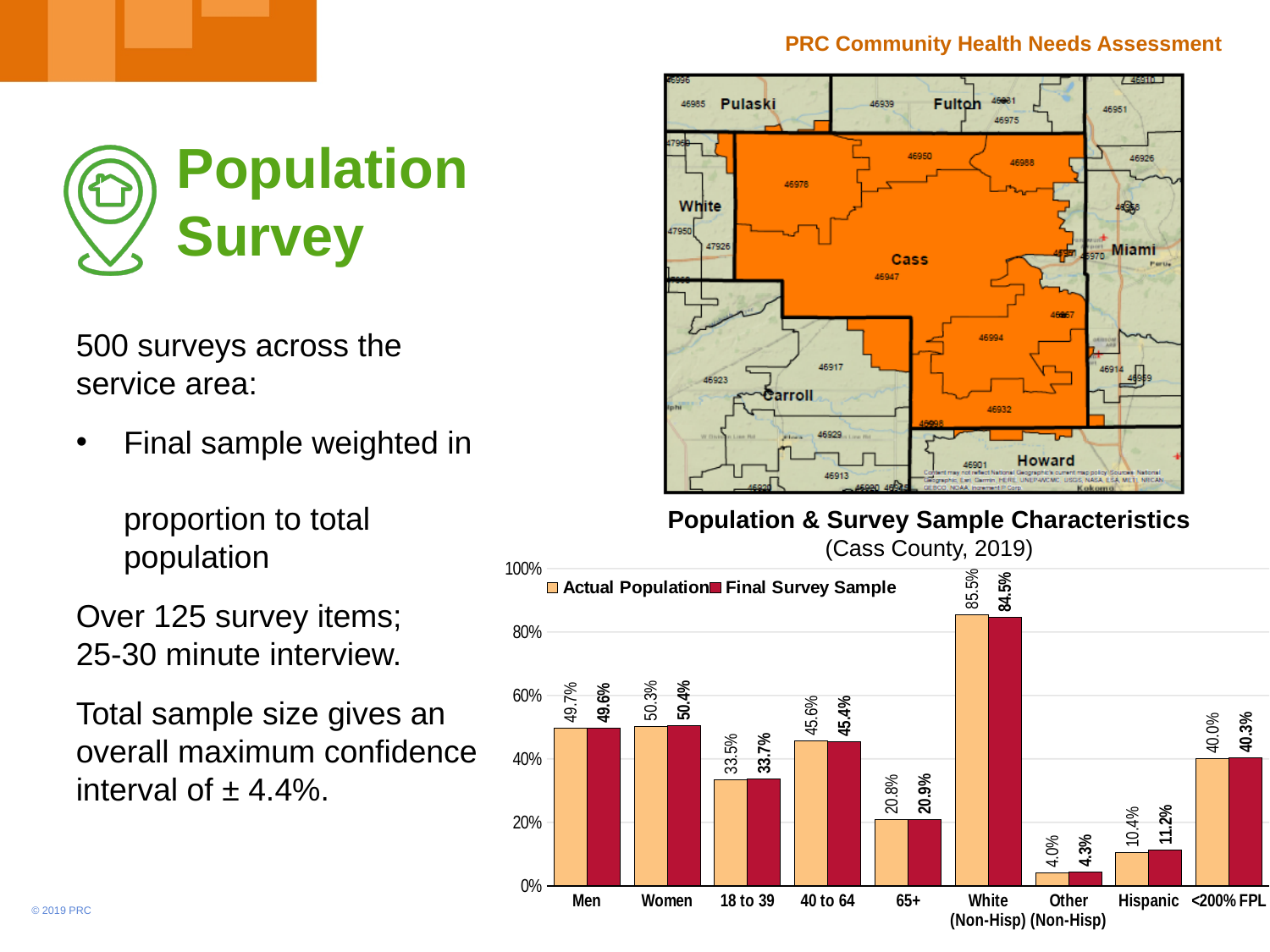
What kind of chart is shown? bar chart What is the Actual Population value for Men? 49.7% How many categories are shown on the x axis? 9 What is the difference between the Actual Population and Final Survey Sample values for White (Non-Hisp)? 1.0% Which is larger for 18 to 39: the Actual Population value or the Final Survey Sample value? Final Survey Sample What is the Actual Population value for White (Non-Hisp)? 85.5% Which category has the lowest Actual Population value? Other (Non-Hisp) What is the Final Survey Sample value for <200% FPL? 40.3% What is the Final Survey Sample value for Hispanic? 11.2% Is the Actual Population value for 65+ greater or less than 40%? less Which category has the highest Final Survey Sample value? White (Non-Hisp) How many series does the legend list? 2